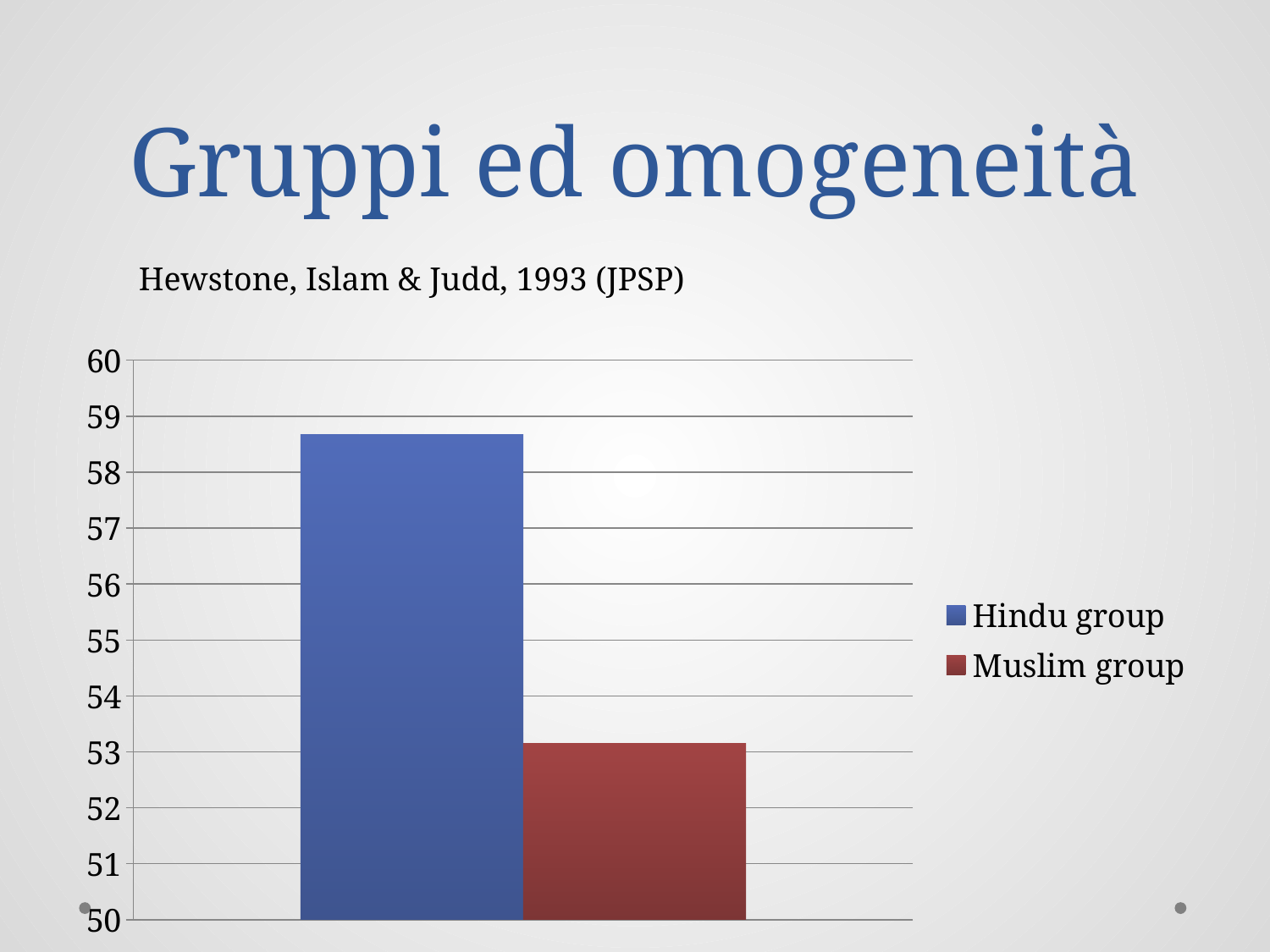
How many bars are plotted in the chart? 2 What colour is the bar for the Muslim group? red Is the value for the Hindu group greater or less than 58? greater What kind of chart is shown on the slide? bar chart How many series does the chart legend list? 2 Is the value for the Muslim group greater or less than 54? less What is the lowest value shown on the vertical axis of the chart? 50 Which group has the highest bar in the chart? Hindu group Is the value for the Muslim group greater or less than 52? greater Which group has the lowest bar in the chart? Muslim group Which is larger, the value for the Hindu group or the value for the Muslim group? Hindu group